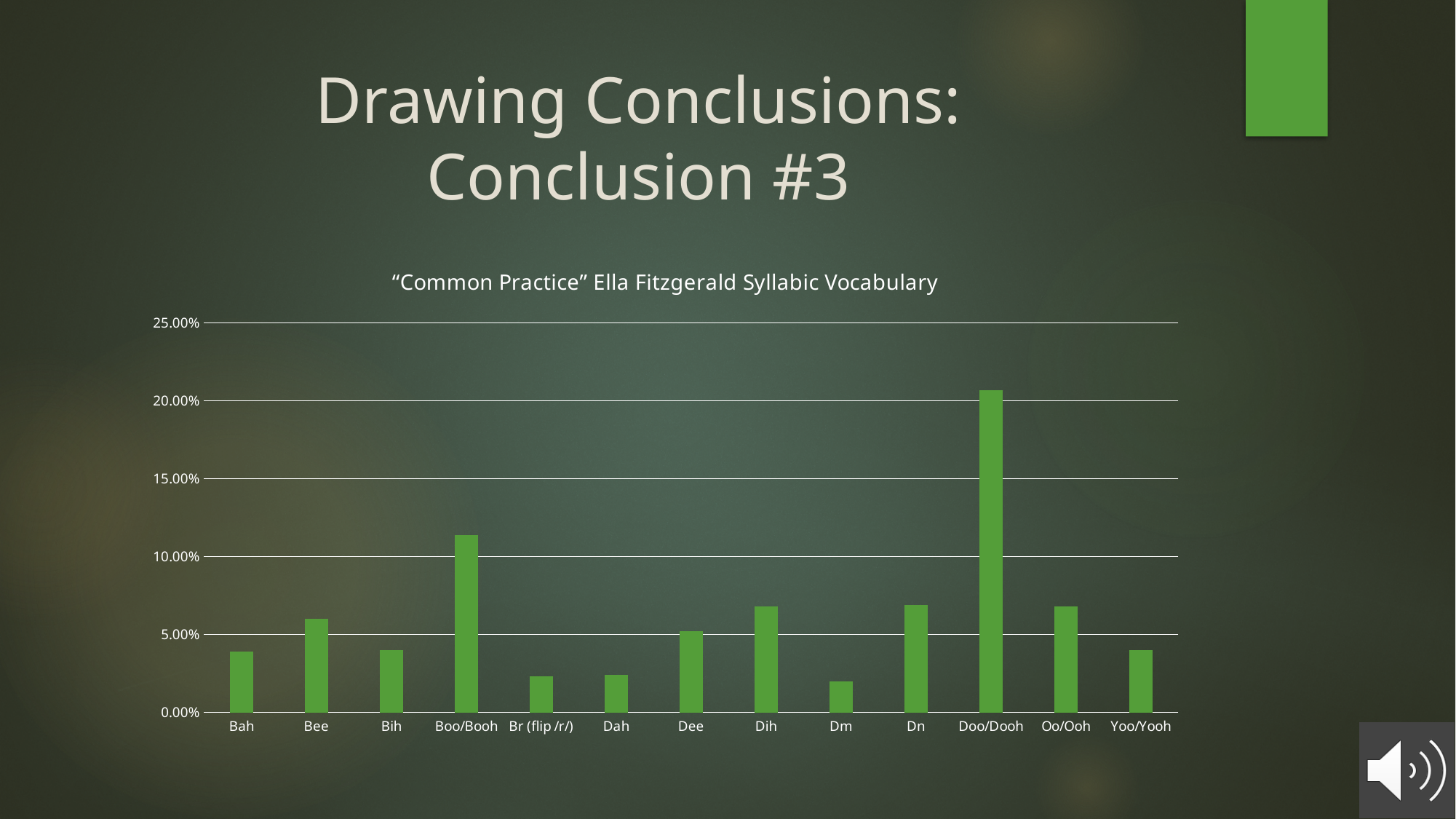
Is the value for Bah greater or less than 5.00%? less Which syllable category has the highest value in the chart? Doo/Dooh How many syllable categories are shown on the x axis of the chart? 13 Which has the larger value, Oo/Ooh or Yoo/Yooh? Oo/Ooh Is the value for Doo/Dooh greater or less than 15.00%? greater What kind of chart is shown on the slide? Bar chart What is the title of the chart? "Common Practice" Ella Fitzgerald Syllabic Vocabulary Is the value for Dm greater or less than 5.00%? less Which has the larger value, Boo/Booh or Bee? Boo/Booh What colour are the bars in the chart? Green